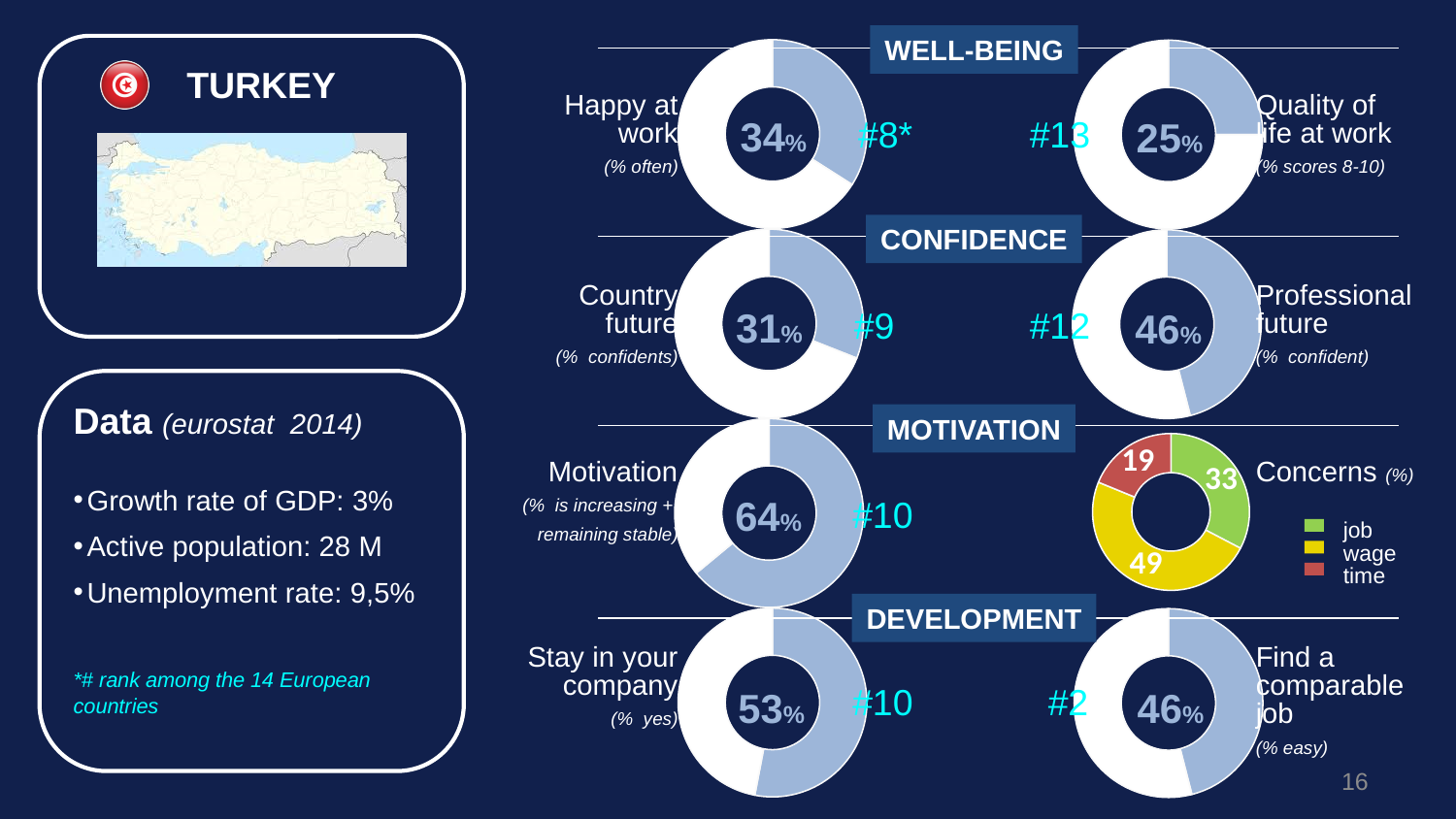
On the 'Quality of life at work' chart, what percentage is shown? 25% On the 'Stay in your company' chart, what percentage answered yes? 53% How many categories does the legend of the 'Concerns' chart list? 3 On the 'Happy at work' chart, what percentage is shown in the centre? 34% On the 'Concerns' chart, what is the difference between the wage value and the job value? 16 On the 'Country future' chart, what percentage of respondents are confident? 31% On the 'Concerns' chart, which concern has the largest share? wage What type of chart is used for 'Concerns'? Donut (pie) chart On the 'Concerns' chart, which concern has the smallest share? time On the 'Concerns' chart, what value is shown for wage? 49 On the 'Motivation' chart, what percentage is shown in the centre? 64% On the 'Professional future' chart, what percentage is shown? 46%